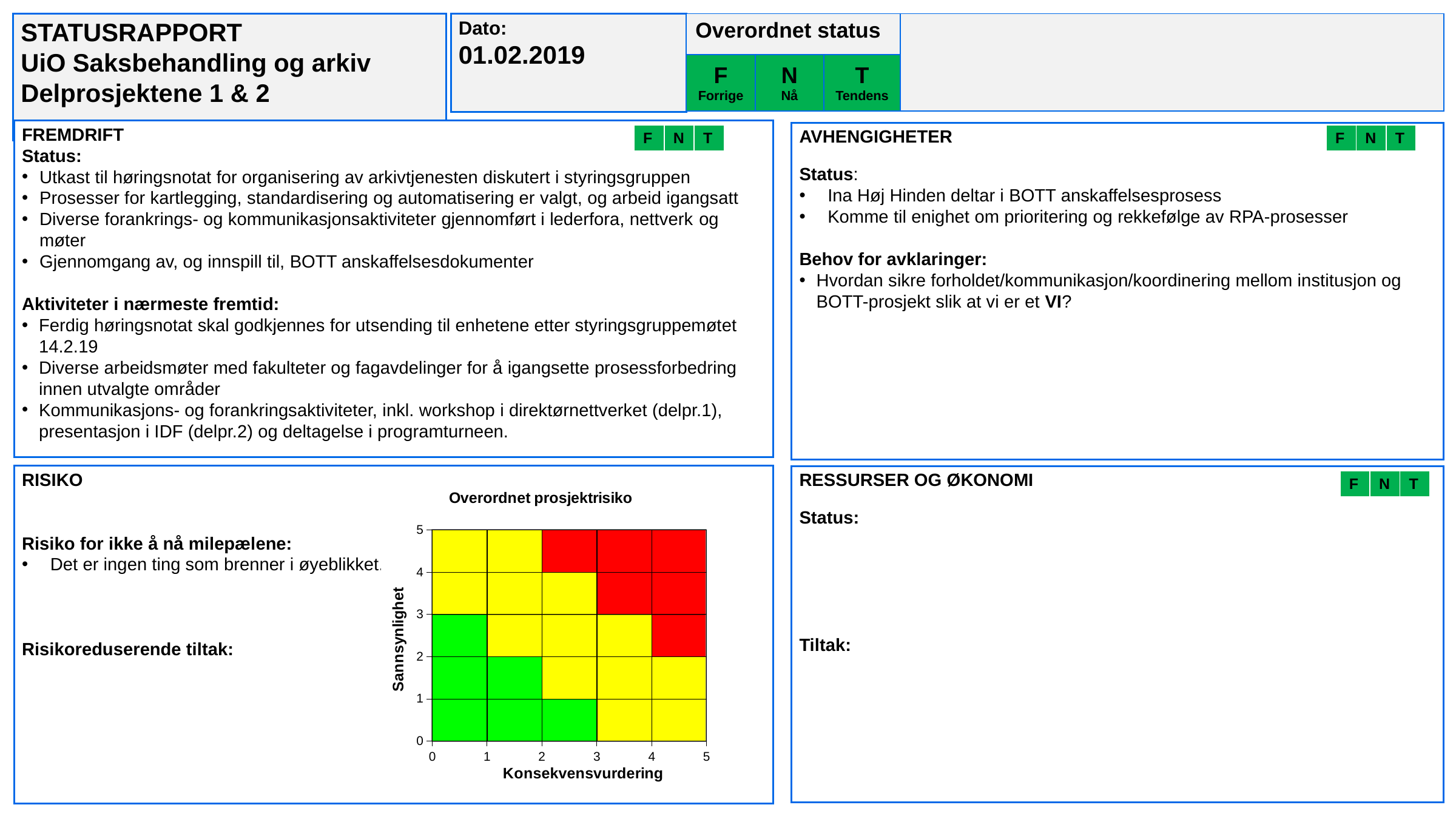
What kind of chart is the Overordnet prosjektrisiko chart? Risk matrix (heat map grid) What are the x-axis and y-axis labels of the Overordnet prosjektrisiko chart? Konsekvensvurdering (x) and Sannsynlighet (y) What is the title of the chart in the RISIKO section? Overordnet prosjektrisiko How many cells does the Overordnet prosjektrisiko grid contain? 25 What is the highest value shown on the Sannsynlighet axis of the Overordnet prosjektrisiko chart? 5